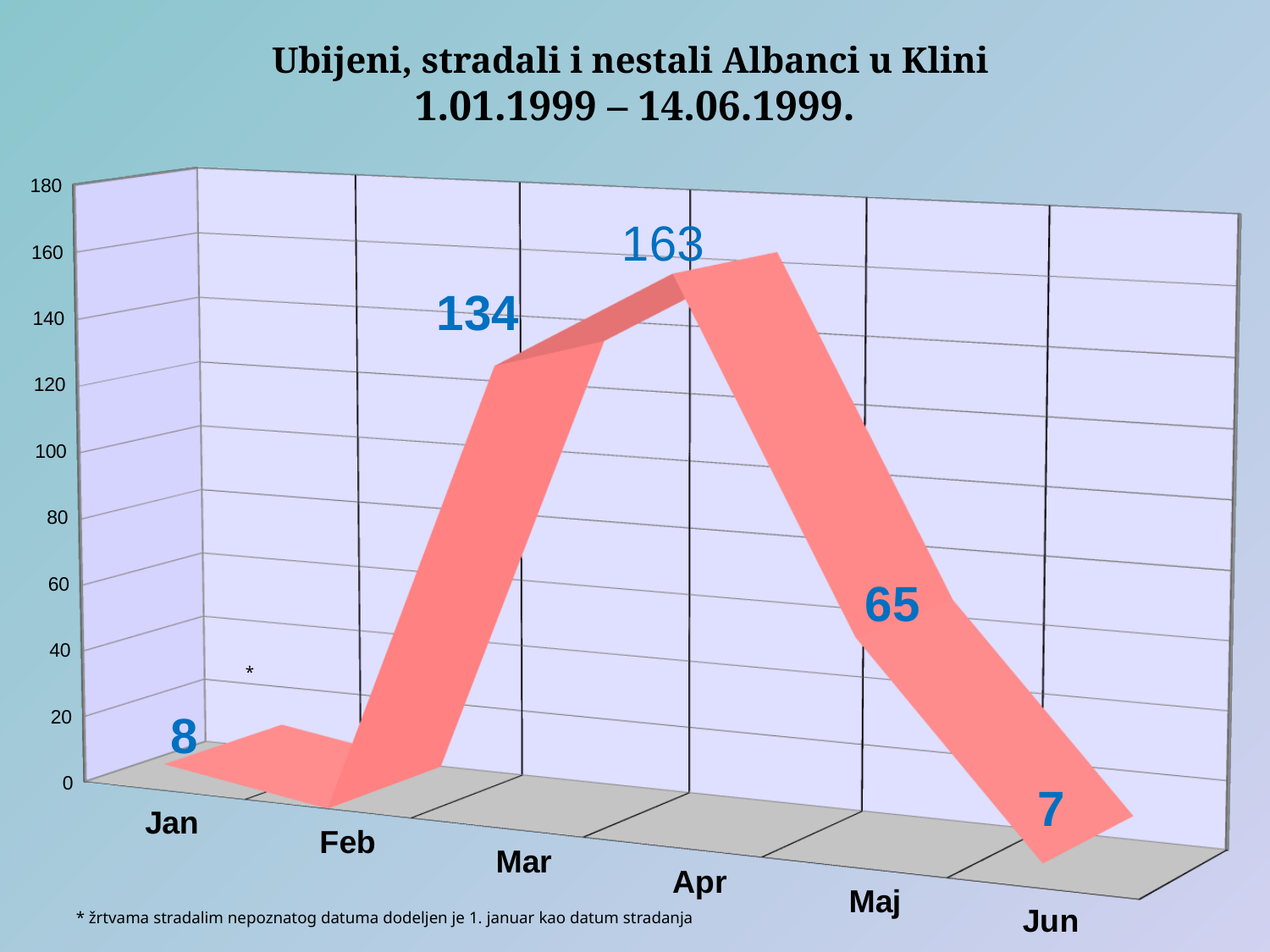
What is the difference between the values for Mar and Maj? 69 Which is larger, the value for Maj or the value for Jun? Maj What is the difference between the values for Apr and Mar? 29 What is the value for Maj? 65 What is the value for Mar? 134 How many months are shown on the x axis? 6 Which month has the highest value? Apr Is the value for Feb greater or less than 20? less What is the value for Apr? 163 What is the value for Jun? 7 What is the value for Jan? 8 What kind of chart is shown on the slide? line chart